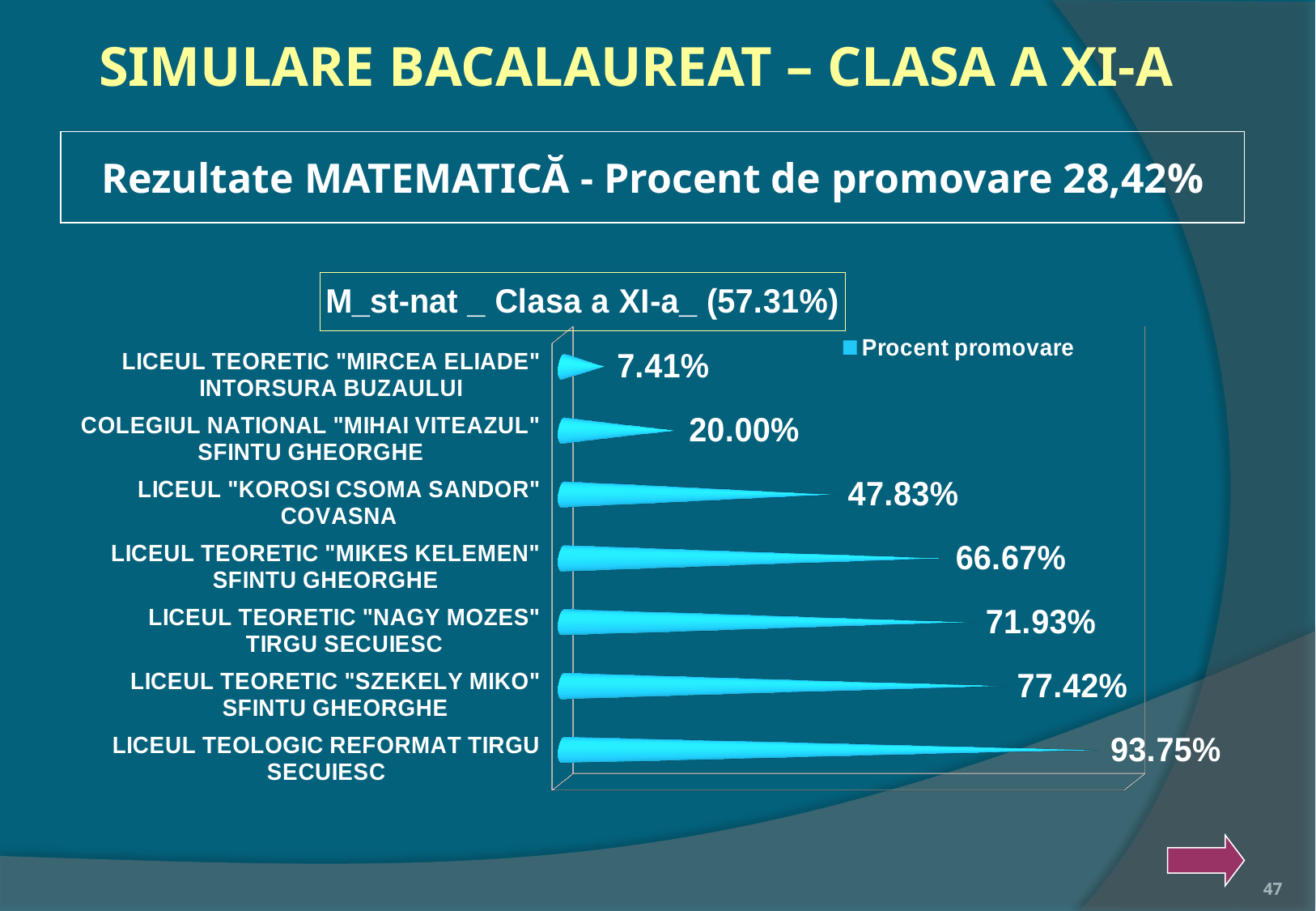
What is the title of the chart? M_st-nat _ Clasa a XI-a_ (57.31%) What is the legend entry of the chart? Procent promovare How many schools are shown in the chart? 7 What is the value for LICEUL TEOLOGIC REFORMAT TIRGU SECUIESC? 93.75% What is the value for LICEUL "KOROSI CSOMA SANDOR" COVASNA? 47.83% What is the value for COLEGIUL NATIONAL "MIHAI VITEAZUL" SFINTU GHEORGHE? 20.00% Which school has the lowest Procent promovare? LICEUL TEORETIC "MIRCEA ELIADE" INTORSURA BUZAULUI What kind of chart is shown on the slide? Bar chart What is the difference between the values for LICEUL TEORETIC "SZEKELY MIKO" SFINTU GHEORGHE and LICEUL TEORETIC "NAGY MOZES" TIRGU SECUIESC? 5.49% Which school has the highest Procent promovare? LICEUL TEOLOGIC REFORMAT TIRGU SECUIESC Which is larger: the value for LICEUL TEORETIC "MIKES KELEMEN" SFINTU GHEORGHE or LICEUL "KOROSI CSOMA SANDOR" COVASNA? LICEUL TEORETIC "MIKES KELEMEN" SFINTU GHEORGHE How many series does the legend list? 1